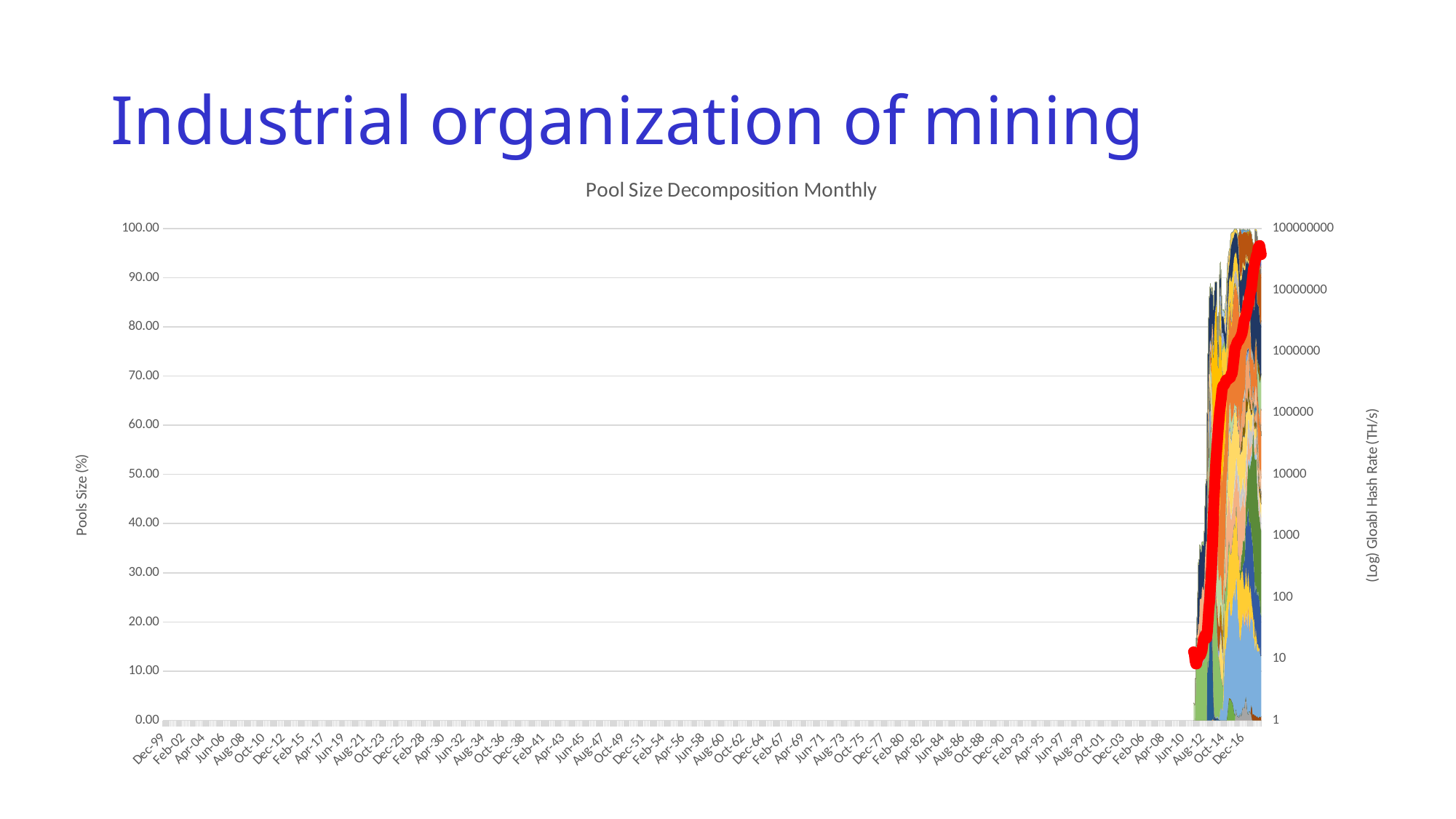
Is the value of the red line at its right-hand end (Dec-16) greater or less than 1000000 on the right axis? greater What is the lowest tick value shown on the right vertical axis? 1 Is the value of the red line at its left-hand start (around Aug-12) greater or less than 100 on the right axis? less What is the highest tick value shown on the left vertical axis? 100.00 What is the highest tick value shown on the right vertical axis? 100000000 What is the label of the left vertical axis? Pools Size (%) What kind of chart is shown on the slide? Stacked area chart with a line overlay Is the value of the red line at Oct-14 greater or less than 10000 on the right axis? greater What is the title of the chart? Pool Size Decomposition Monthly Does the red line rise or fall as it moves from left to right along the x axis? Rises